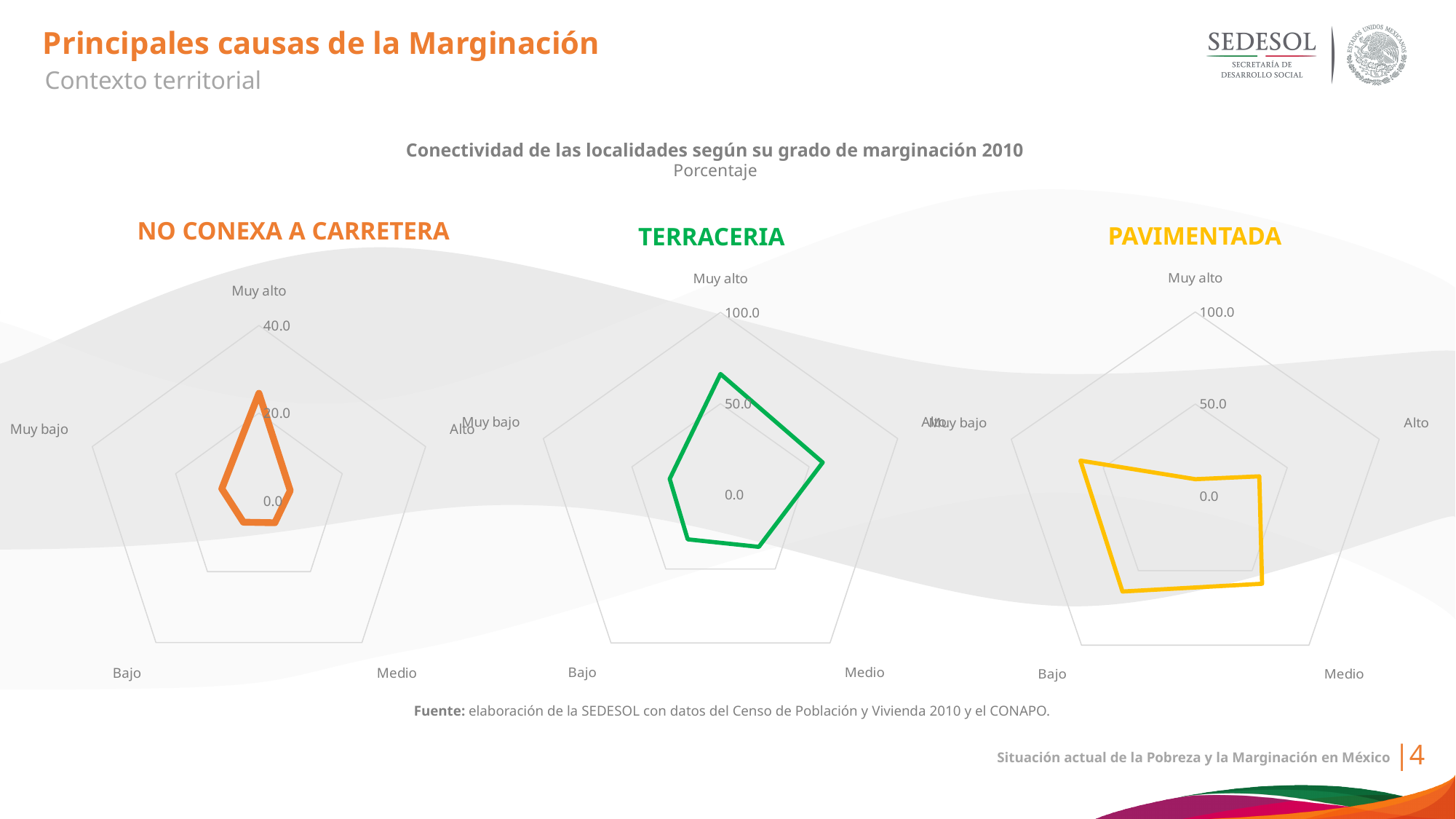
In the NO CONEXA A CARRETERA chart, is the value for Muy alto greater or less than 20.0? greater What colour is the data line in the TERRACERIA chart? Green How many categories (marginación levels) does each radar chart show? 5 In the TERRACERIA chart, which is larger, the value for Muy alto or the value for Medio? Muy alto In the TERRACERIA chart, which category has the highest value? Muy alto In the PAVIMENTADA chart, is the value for Bajo greater or less than 50.0? greater In the PAVIMENTADA chart, is the value for Alto greater or less than 50.0? less In the NO CONEXA A CARRETERA chart, which category has the highest value? Muy alto In the PAVIMENTADA chart, which category has the lowest value? Muy alto What kind of chart is used for the NO CONEXA A CARRETERA panel? Radar chart In the PAVIMENTADA chart, which is larger, the value for Bajo or the value for Muy alto? Bajo